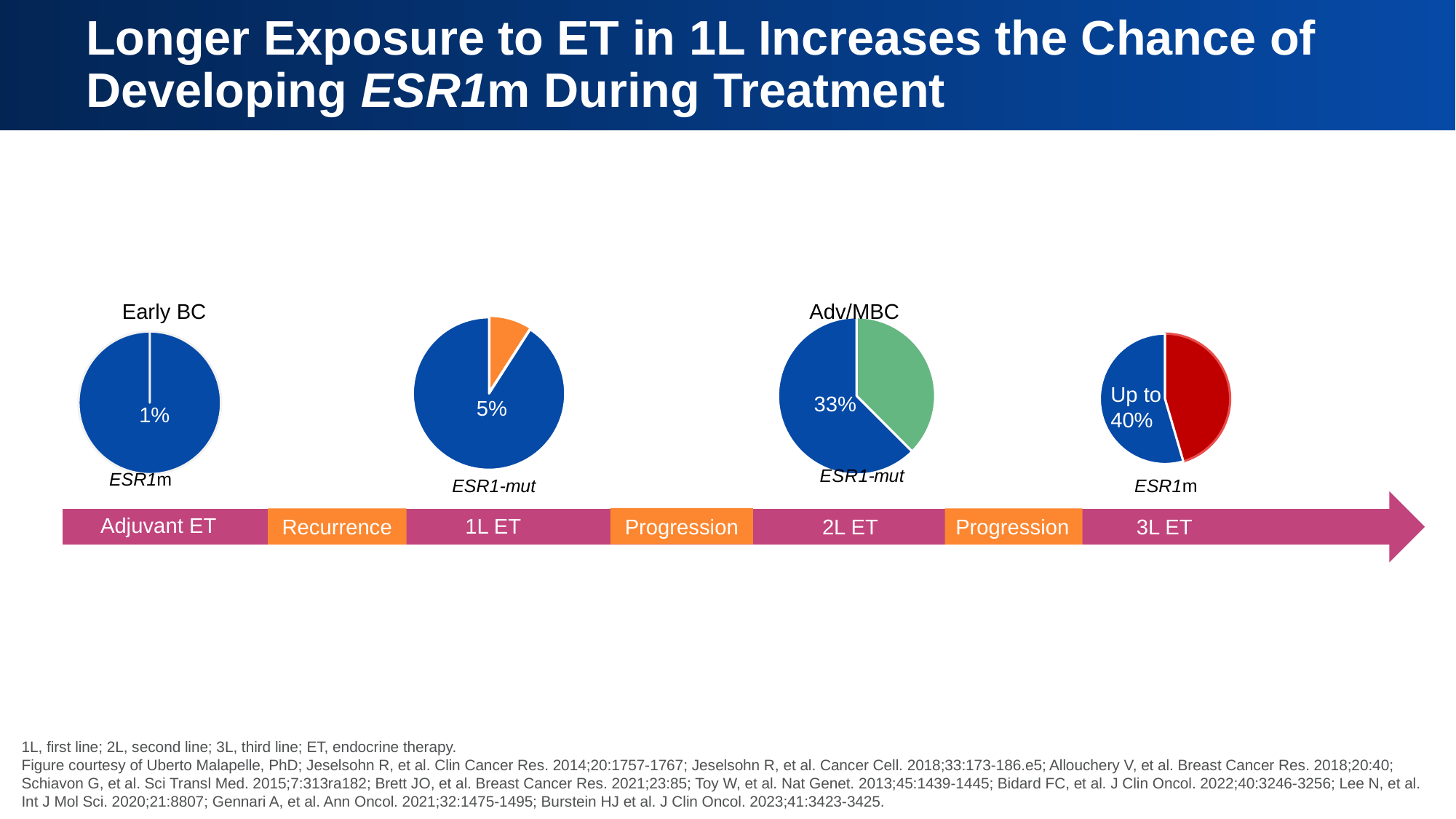
In the pie chart above the Adjuvant ET stage (Early BC), what percentage is shown for ESR1m? 1% What is the difference between the ESR1-mut percentage in the 2L ET pie chart and the 1L ET pie chart? 28 percentage points What colour is the ESR1-mut slice in the pie chart above the 2L ET stage? Green Which is larger, the ESR1-mut percentage in the 2L ET pie chart or in the 1L ET pie chart? 2L ET Which treatment stage's pie chart shows the lowest ESR1 mutation percentage? Adjuvant ET What kind of charts are used to show the ESR1 mutation rates along the treatment timeline? Pie charts Do the ESR1 mutation percentages rise or fall moving from Adjuvant ET to 3L ET along the timeline? Rise Which treatment stage's pie chart shows the highest ESR1 mutation percentage? 3L ET In the pie chart above the 2L ET stage (Adv/MBC), what percentage is shown for ESR1-mut? 33% In the pie chart above the 1L ET stage, what percentage is shown for ESR1-mut? 5% In the pie chart above the 3L ET stage, what value is shown for ESR1m? Up to 40% How many pie charts are shown on the slide? 4